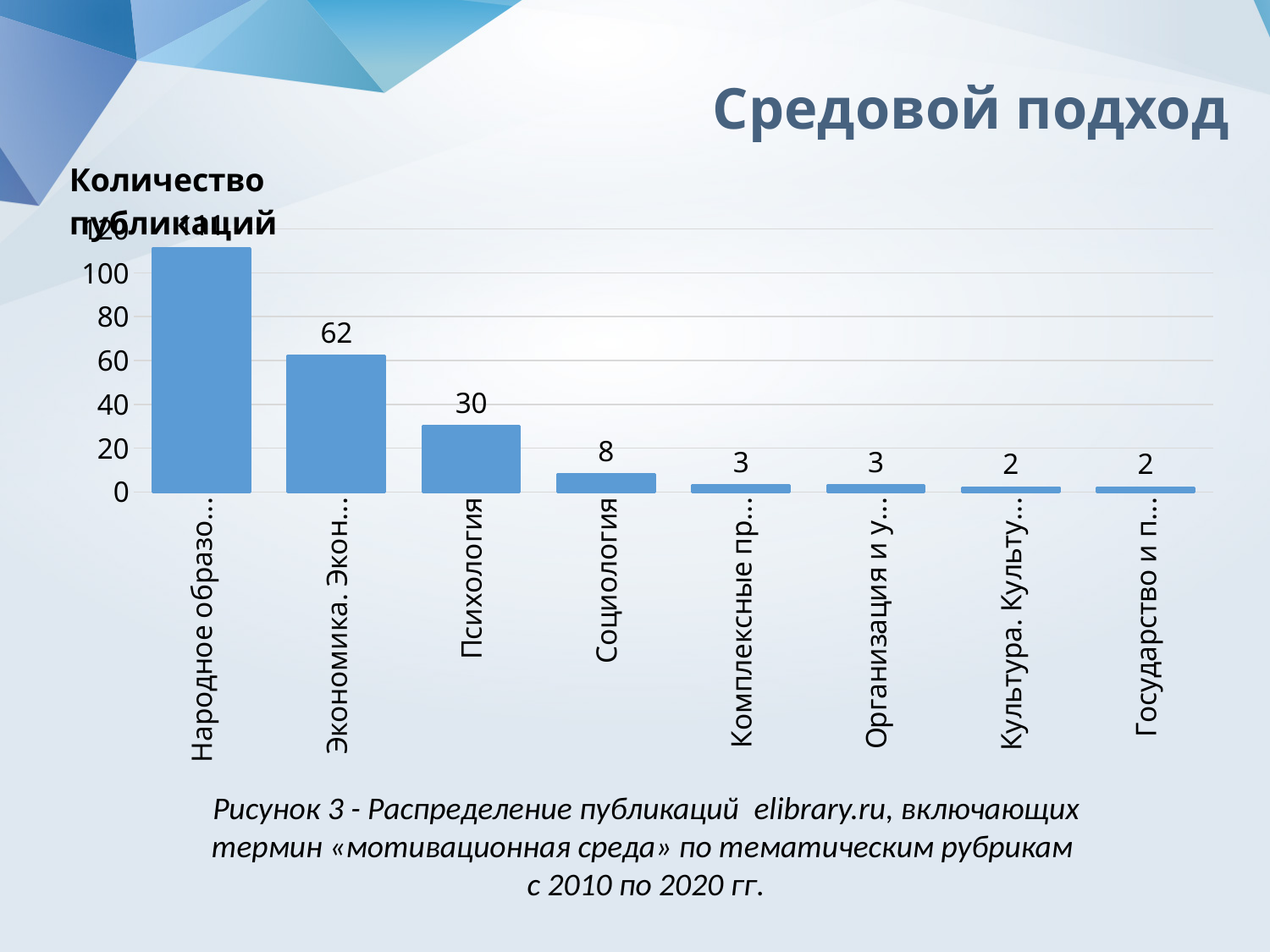
What kind of chart is shown on the slide? Bar chart What is the value for Социология? 8 Is the value for the first bar (Народное образо...) greater or less than 100? greater What is the lowest value shown on the chart? 2 What is the value for Психология? 30 What is the difference between the second bar (62) and Психология (30)? 32 What is the difference between the values for Психология and Социология? 22 Which category has the highest number of publications? The first bar, Народное образо... Do the values rise or fall from left to right along the x axis? Fall What is the value shown on the second bar from the left (Экономика. Экон...)? 62 How many categories are shown on the chart? 8 Which is larger, the value for Психология or the value for Социология? Психология